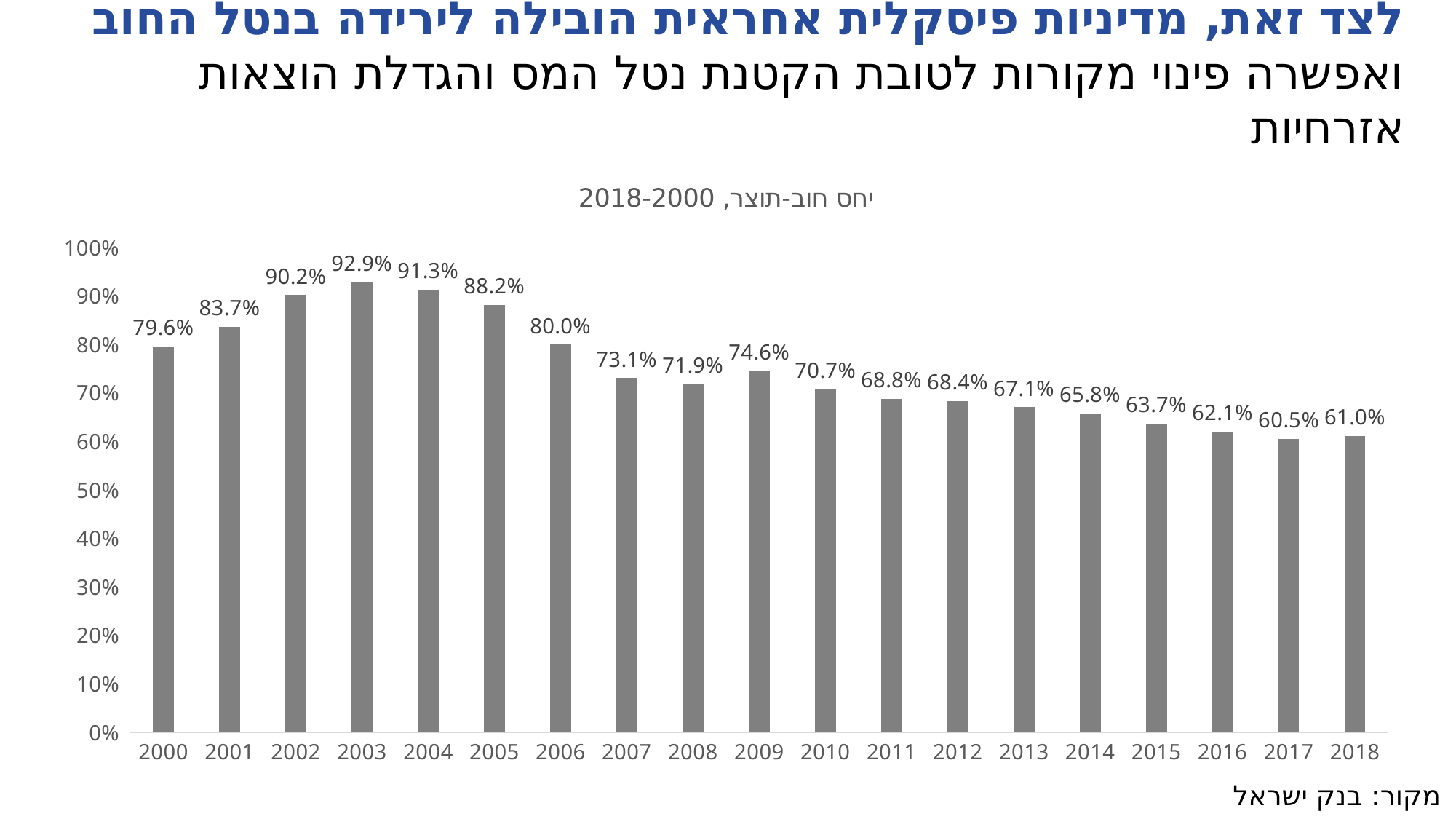
What is the debt-to-GDP ratio shown for 2003? 92.9% What is the difference between the values for 2003 and 2018? 31.9% Which year has a larger value, 2008 or 2009? 2009 Which year has the highest value in the chart? 2003 What is the difference between the values for 2000 and 2001? 4.1% What is the value shown for 2018? 61.0% What kind of chart is shown on the slide? Bar chart How many years are shown on the x axis? 19 What is the value shown for 2010? 70.7% Do the values generally rise or fall from 2003 to 2018? Fall Is the value for 2006 greater or less than 70%? greater Which year has the lowest value in the chart? 2017